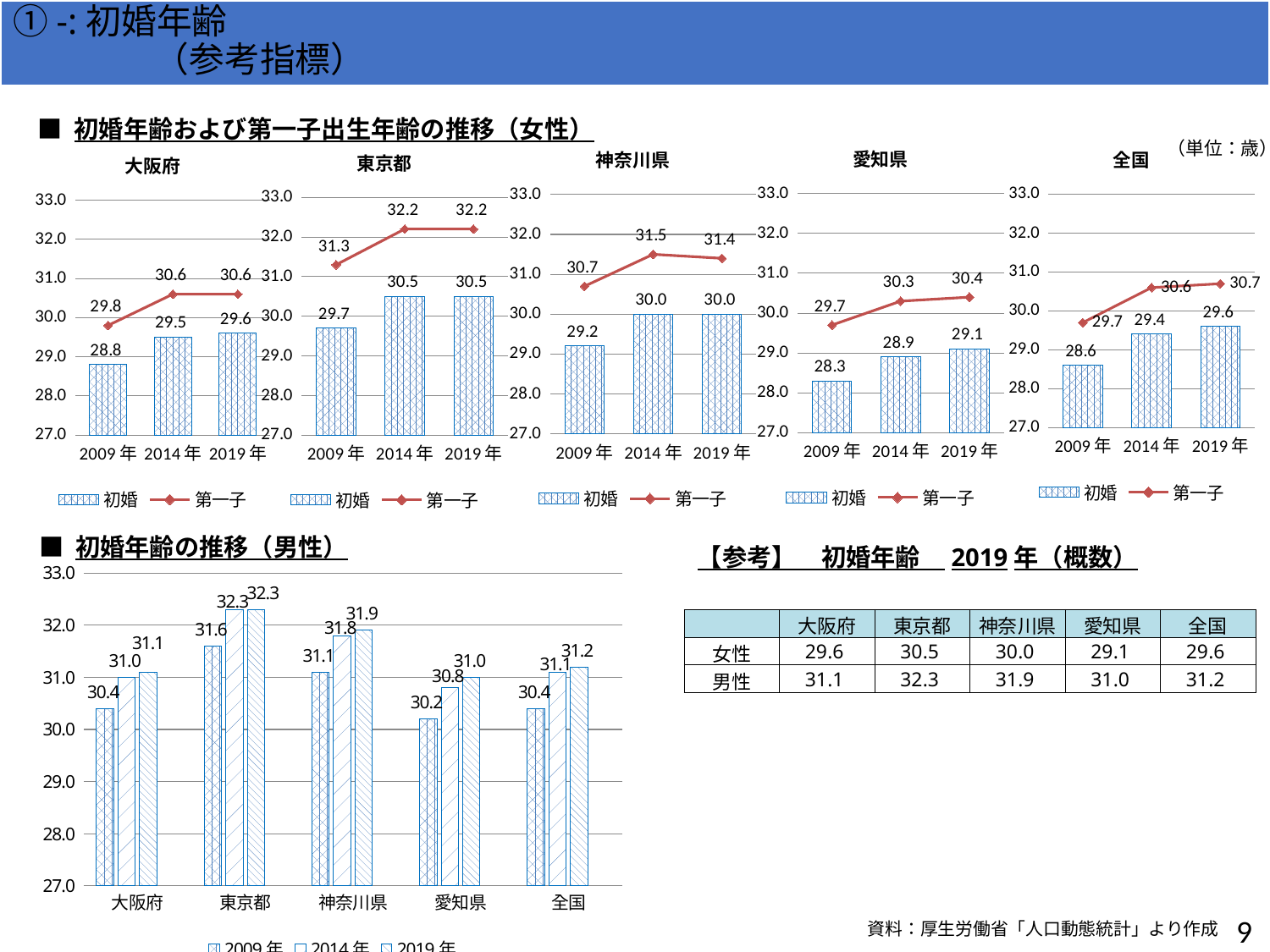
In the 東京都 chart (women), what is the 第一子 value for 2014年? 32.2 In the 初婚年齢の推移（男性） chart, how many regions are shown on the x axis? 5 In the 初婚年齢の推移（男性） chart, how many series does the legend list? 3 In the 全国 chart (women), which year has the lowest 初婚 value? 2009年 In the 愛知県 chart (women), what is the 初婚 value for 2009年? 28.3 In the 初婚年齢の推移（男性） chart, which region has the highest 2009年 value? 東京都 In the 東京都 chart (women), do the 第一子 values rise or fall from 2009年 to 2014年? rise In the 大阪府 chart (women), what is the 初婚 value for 2019年? 29.6 In the 初婚年齢の推移（男性） chart, what is the 2019年 value for 東京都? 32.3 In the 大阪府 chart (women), what kind of chart is used for the 初婚 series? bar chart In the 初婚年齢の推移（男性） chart, is the 2014年 value for 神奈川県 larger or smaller than the 2014年 value for 愛知県? larger In the 神奈川県 chart (women), what is the difference between the 第一子 value and the 初婚 value in 2019年? 1.4